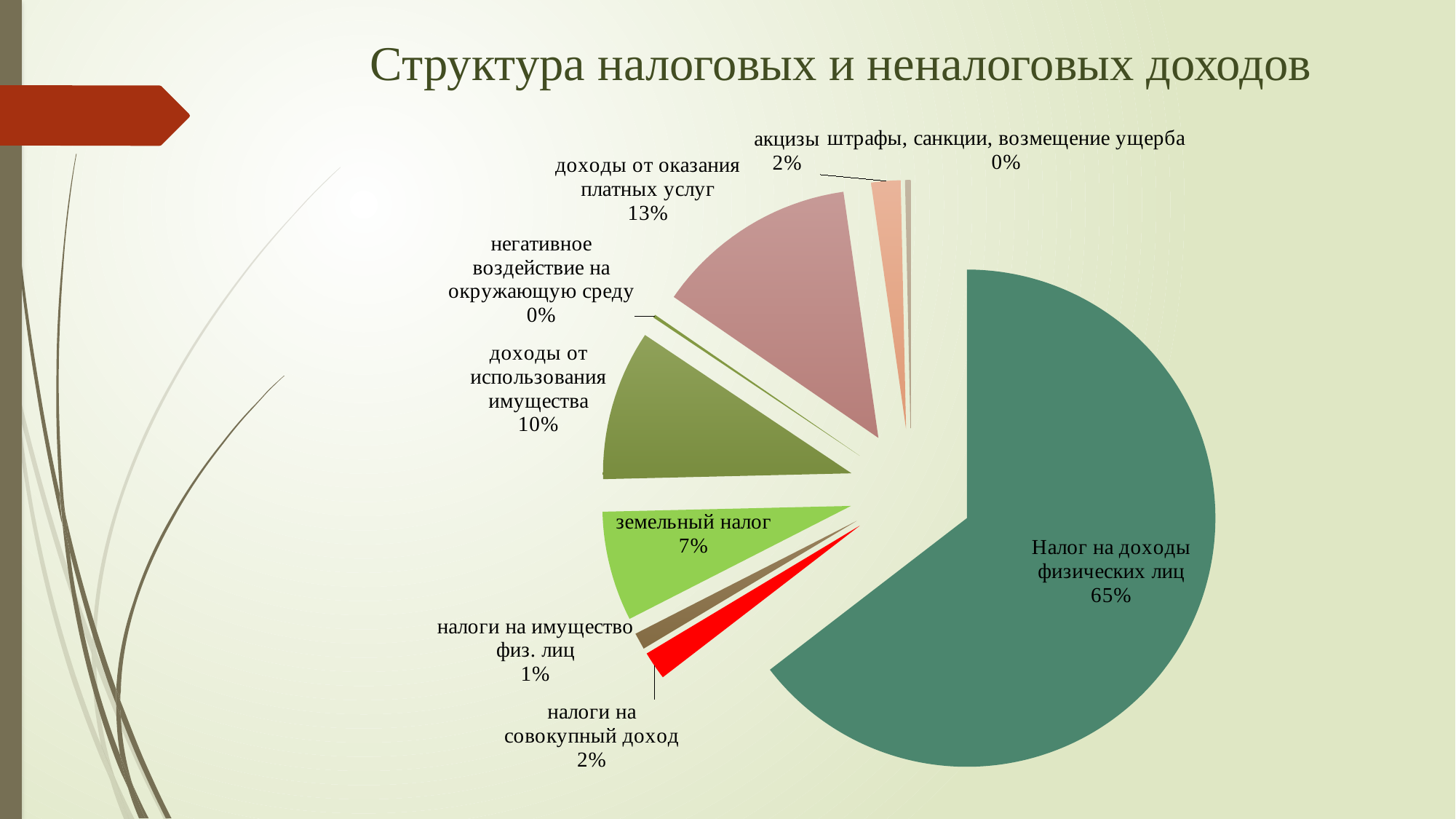
Which is larger: the share of "земельный налог" or the share of "доходы от использования имущества"? доходы от использования имущества What share of the pie is "земельный налог"? 7% What is the title of the chart? Структура налоговых и неналоговых доходов What share of the pie is "доходы от оказания платных услуг"? 13% What share of the pie is "акцизы"? 2% What is the difference between the shares of "Налог на доходы физических лиц" and "доходы от оказания платных услуг"? 52% How many slices (categories) does the pie chart have? 9 What kind of chart is shown on the slide? pie chart Which category has the largest slice of the pie? Налог на доходы физических лиц